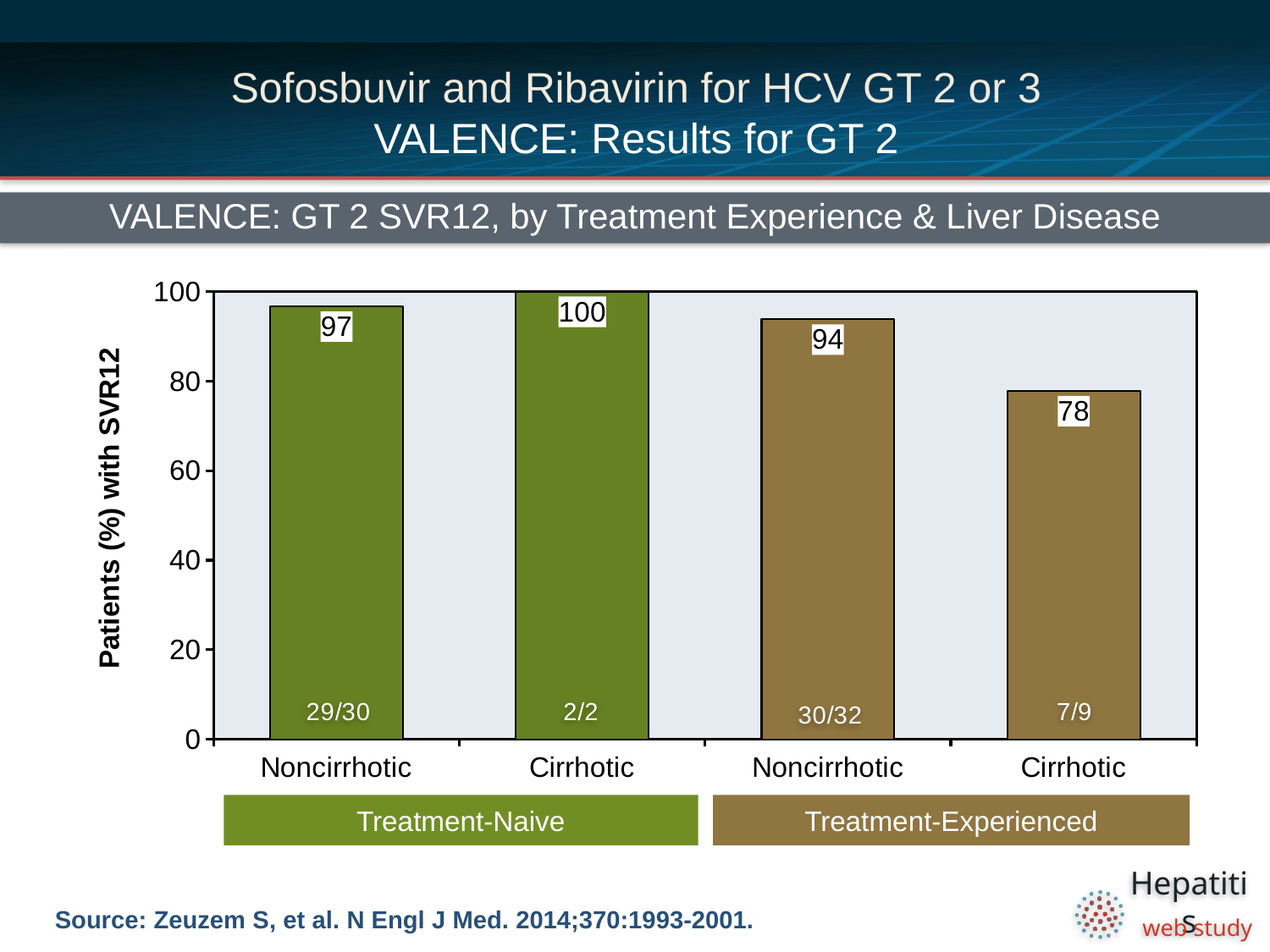
What is the SVR12 rate for Treatment-Naive Noncirrhotic patients? 97 What is the SVR12 rate for Treatment-Experienced Noncirrhotic patients? 94 What is the label of the y-axis? Patients (%) with SVR12 How many bars are shown in the chart? 4 Which group has the lowest SVR12 rate? Treatment-Experienced Cirrhotic What is the difference in SVR12 rate between Treatment-Experienced Noncirrhotic and Treatment-Experienced Cirrhotic patients? 16 Which group has the highest SVR12 rate? Treatment-Naive Cirrhotic What type of chart is shown on the slide? Bar chart What is the SVR12 rate for Treatment-Experienced Cirrhotic patients? 78 Which has a higher SVR12 rate: Treatment-Naive Noncirrhotic or Treatment-Experienced Noncirrhotic? Treatment-Naive Noncirrhotic Is the SVR12 rate for Treatment-Experienced Cirrhotic patients greater or less than 80? less What fraction of patients is shown inside the Treatment-Naive Cirrhotic bar? 2/2